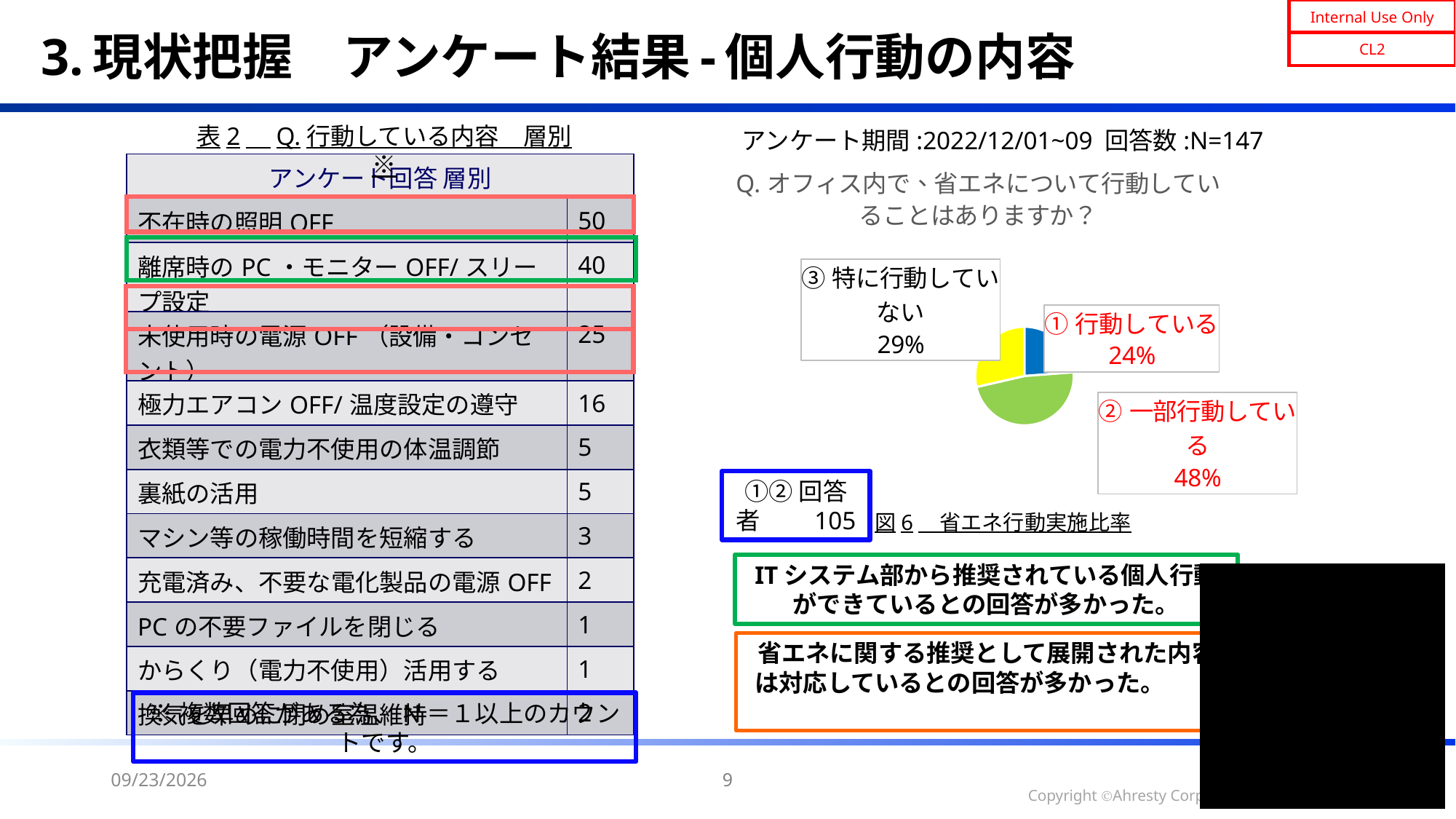
How many categories are shown in the 図6 pie chart? 3 What is the number of respondents (N) stated for the survey shown in the pie chart? N=147 What is the title of the pie chart on the slide? Q. オフィス内で、省エネについて行動していることはありますか？ What share of respondents answered ② 一部行動している in the 図6 pie chart? 48% Which category has the largest share in the 図6 pie chart? ② 一部行動している What kind of chart is 図6? Pie chart Which category has the smallest share in the 図6 pie chart? ① 行動している In the 図6 pie chart, how many percentage points larger is ② 一部行動している than ① 行動している? 24 percentage points In the 図6 pie chart, how many percentage points larger is ③ 特に行動していない than ① 行動している? 5 percentage points What share of respondents answered ③ 特に行動していない in the 図6 pie chart? 29% In the 図6 pie chart, which is larger: the share for ② 一部行動している or the share for ③ 特に行動していない? ② 一部行動している What share of respondents answered ① 行動している in the 図6 pie chart? 24%